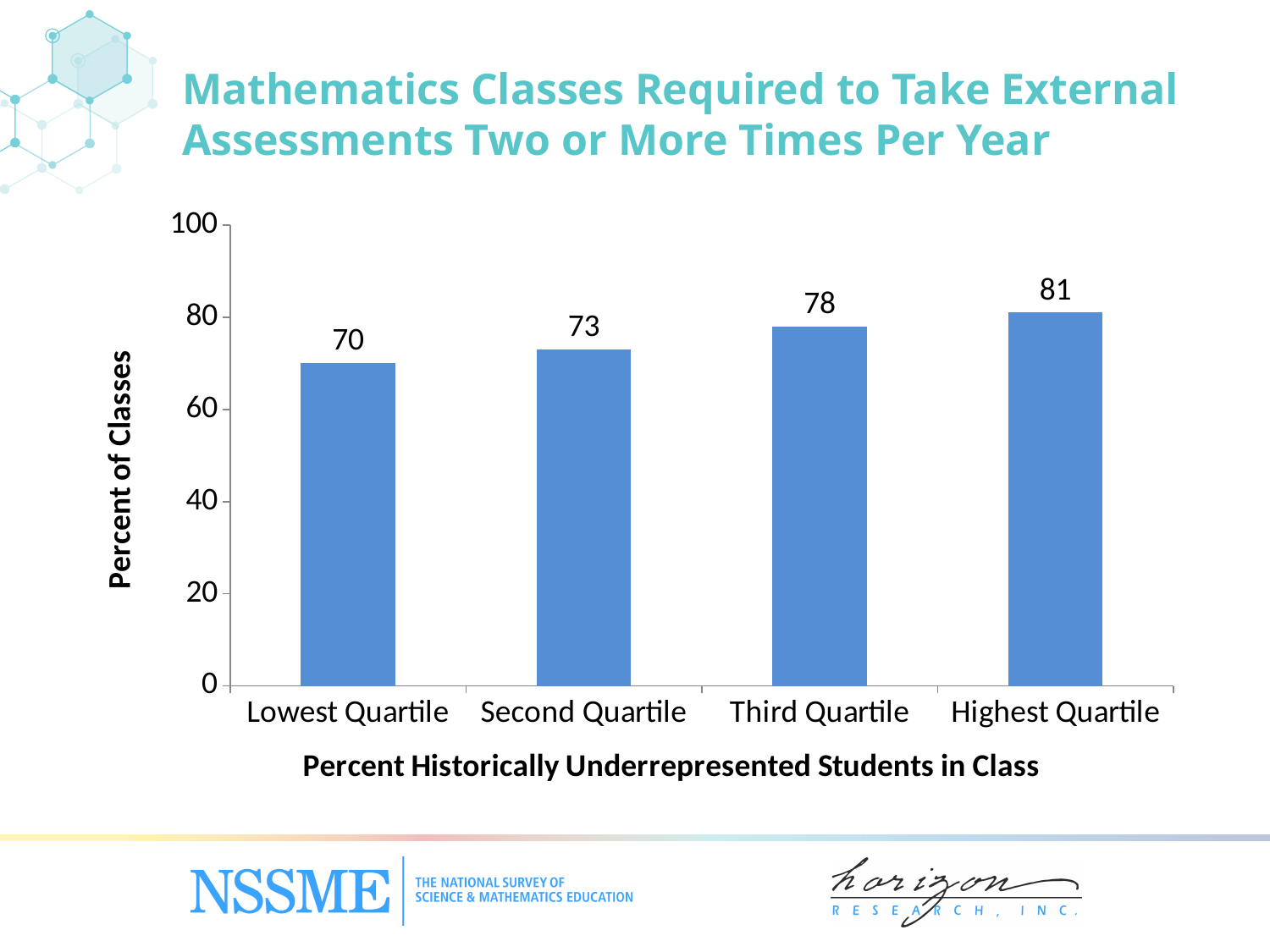
What is the value for Highest Quartile? 81 Which is larger, the value for Third Quartile or the value for Second Quartile? Third Quartile Which category has the highest value? Highest Quartile Is the value for Second Quartile greater or less than 80? less What is the difference between the values for Highest Quartile and Lowest Quartile? 11 How many categories are shown on the x axis? 4 What kind of chart is shown on the slide? bar chart What is the value for Lowest Quartile? 70 What is the value for Second Quartile? 73 Which category has the lowest value? Lowest Quartile What is the value for Third Quartile? 78 Do the values rise or fall from Lowest Quartile to Highest Quartile? rise